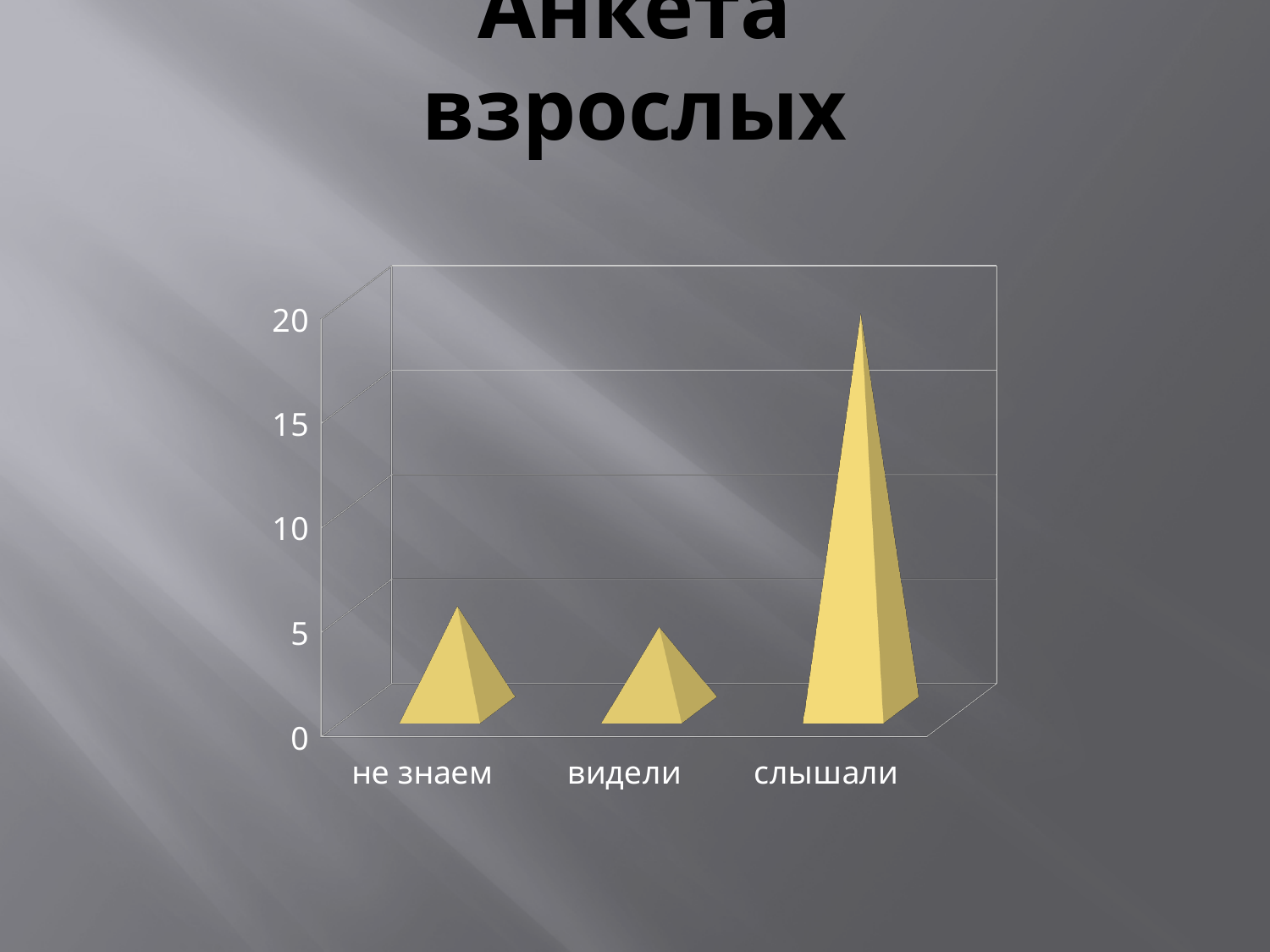
What kind of chart is shown on the slide? bar chart Which is larger, the value for слышали or the value for видели? слышали What is the highest value labelled on the vertical axis of the chart? 20 What is the title of the slide containing the chart? Анкета взрослых Which category has the lowest value in the chart? видели How many categories are shown on the x axis of the chart? 3 Is the value for не знаем greater or less than 10? less Which is larger, the value for не знаем or the value for видели? не знаем Is the value for видели greater or less than 10? less Which category has the highest value in the chart? слышали Is the value for слышали greater or less than 15? greater